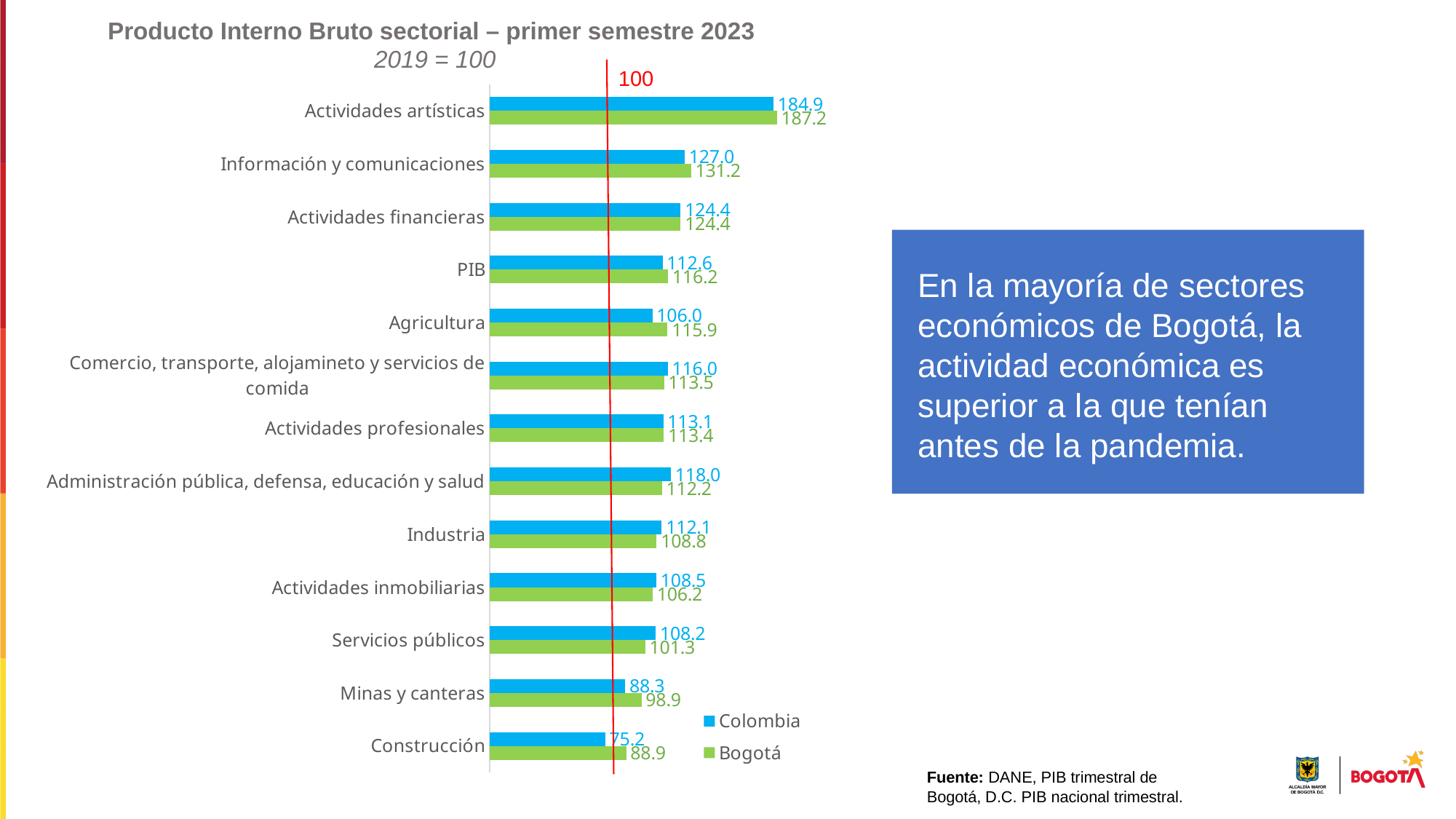
Which category has the lowest Colombia value? Construcción For Servicios públicos, which is larger: the Colombia value or the Bogotá value? Colombia What is the Colombia value for Minas y canteras? 88.3 What is the Bogotá value for Actividades artísticas? 187.2 How many series does the legend list? 2 What kind of chart is shown on the slide? Bar chart What is the difference between the Bogotá and Colombia values for Agricultura? 9.9 Which category has the highest Bogotá value? Actividades artísticas What is the Bogotá value for PIB? 116.2 What is the Colombia value for Construcción? 75.2 How many categories are shown on the chart? 13 What value does the red vertical reference line on the chart mark? 100